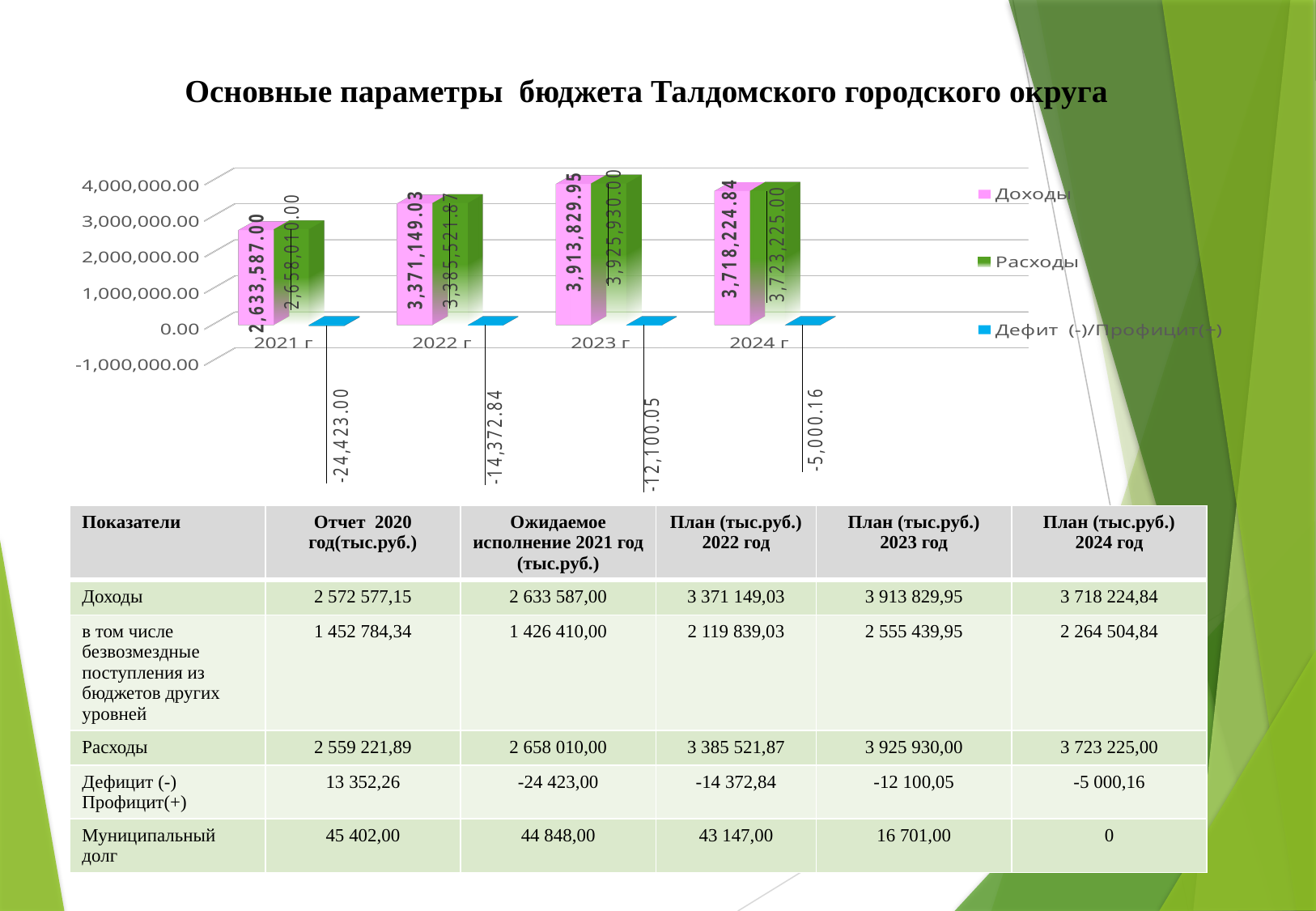
What is the value of Доходы for 2022 г in the chart? 3,371,149.03 What is the value of Дефицит (-)/Профицит(+) for 2021 г in the chart? -24,423.00 How many series does the chart legend list? 3 Is the value of Доходы for 2021 г greater or less than 3,000,000.00? less Which series in the chart is shown in pink? Доходы In which year is Доходы highest in the chart? 2023 г What is the difference between Расходы and Доходы for 2024 г in the chart? 5,000.16 What type of chart is shown on the slide? bar chart How many year categories are shown on the x axis of the chart? 4 In which year is Расходы lowest in the chart? 2021 г What is the value of Расходы for 2023 г in the chart? 3,925,930.00 Which is larger in the chart for 2024 г: Доходы or Расходы? Расходы